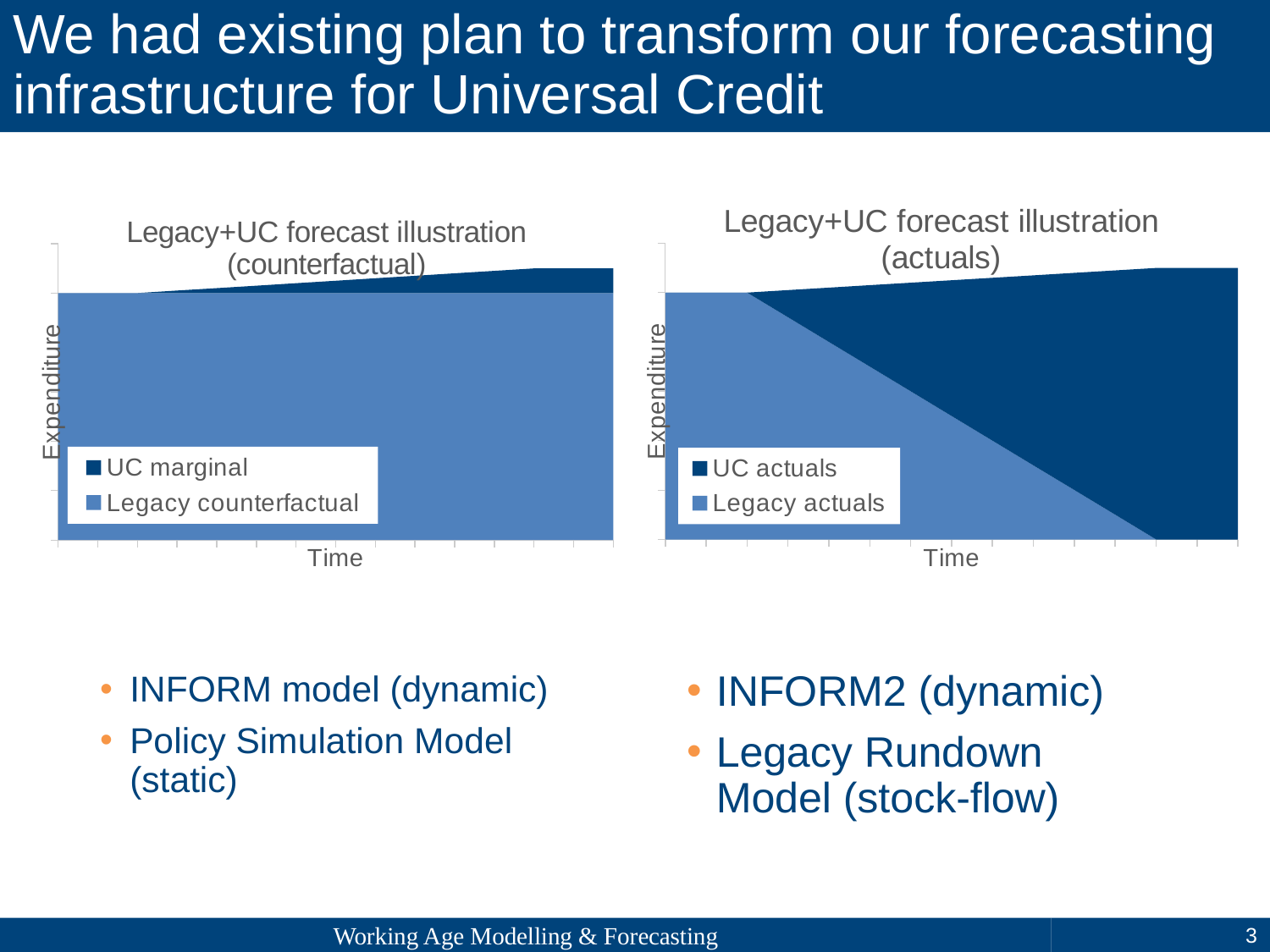
How many series does the legend of the right chart (actuals) list? 2 In the right chart (actuals), does the Legacy actuals series rise or fall over time? Fall How many series does the legend of the left chart (counterfactual) list? 2 What is the label on the vertical axis of the right chart (actuals)? Expenditure In the left chart (counterfactual), which series is shown in the darker blue? UC marginal In the left chart (counterfactual), does the UC marginal series rise or fall over time? Rise In the right chart (actuals), does the UC actuals series rise or fall over time? Rise What kind of chart is the left chart titled 'Legacy+UC forecast illustration (counterfactual)'? Area chart What kind of chart is the right chart titled 'Legacy+UC forecast illustration (actuals)'? Area chart